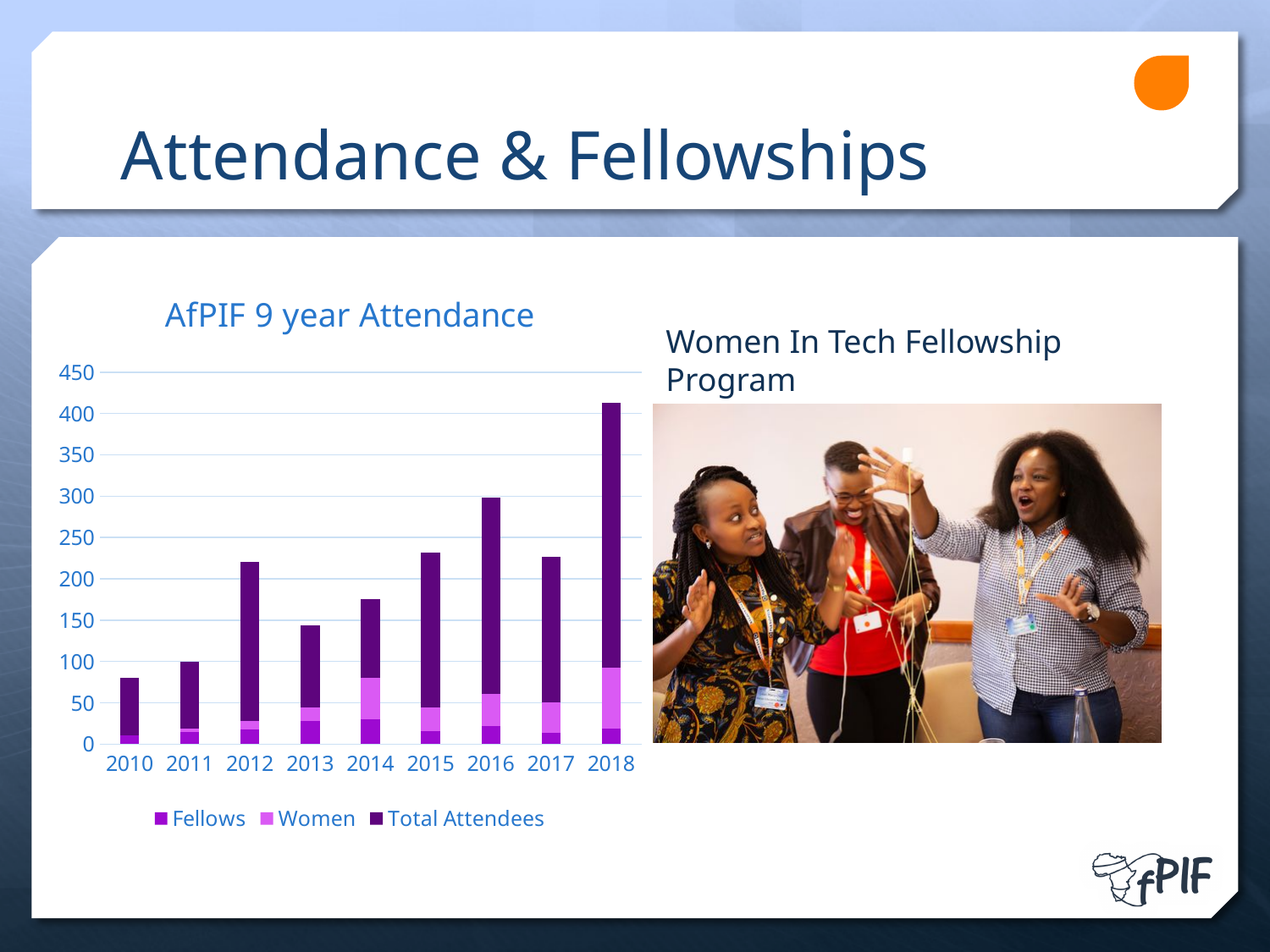
What kind of chart is shown on the slide? Stacked bar chart Is the total height of the bar for 2010 greater or less than 100? less Which year has the shortest bar in the chart? 2010 Is the total height of the bar for 2014 greater or less than 200? less How many years are shown on the x axis of the chart? 9 Is the total height of the bar for 2016 greater or less than 250? greater Which year has the taller bar, 2016 or 2017? 2016 Which series are listed in the chart's legend? Fellows, Women, Total Attendees What is the title of the chart on the slide? AfPIF 9 year Attendance How many series does the chart's legend list? 3 Which year has the tallest bar in the chart? 2018